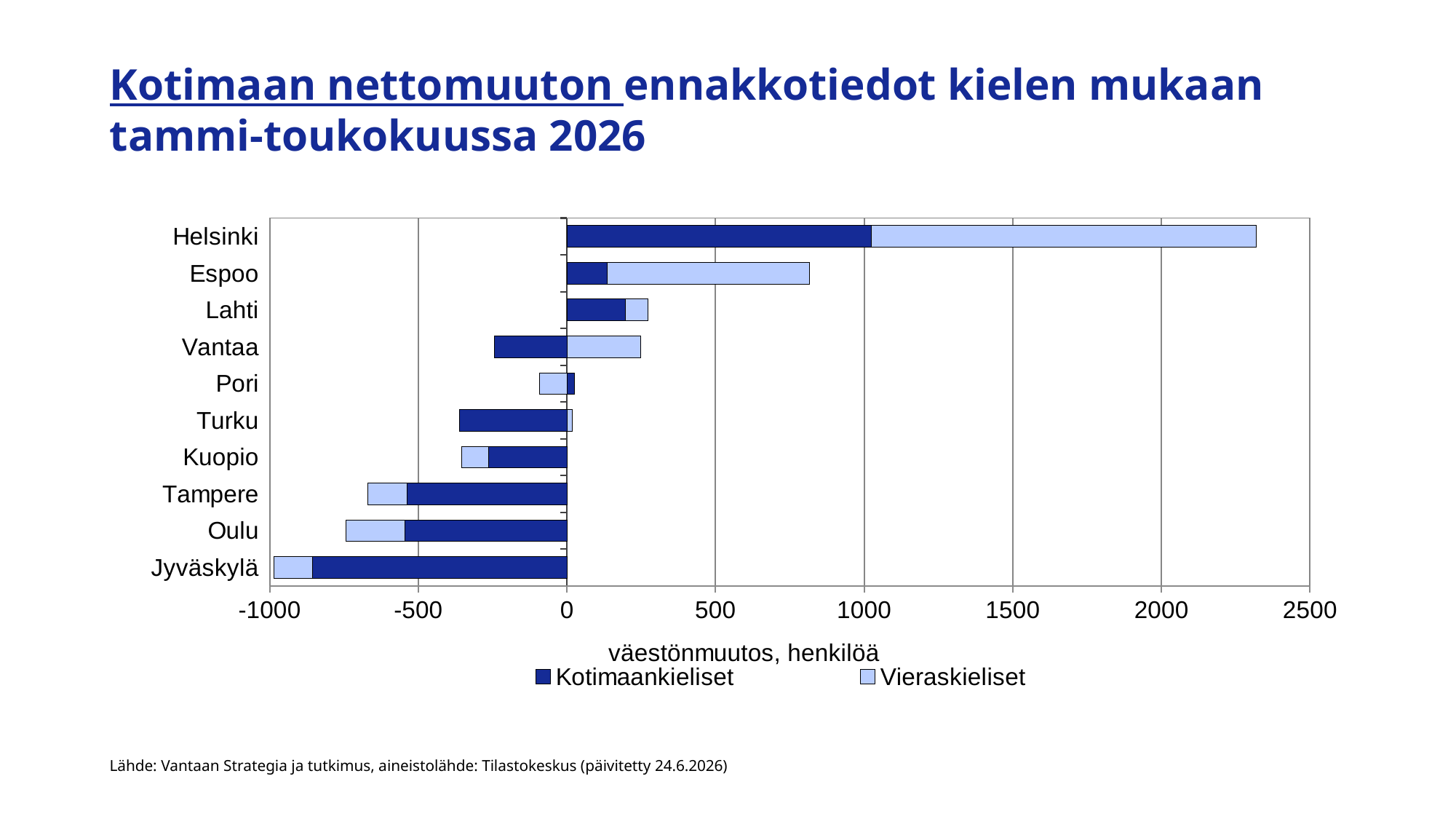
What kind of chart is shown on the slide? Bar chart Is the Kotimaankieliset value for Espoo greater or less than 500? less Is the Kotimaankieliset value for Jyväskylä greater or less than -500? less How many cities are listed on the vertical axis of the chart? 10 Which city has the highest Kotimaankieliset value? Helsinki Is the Vieraskieliset value for Helsinki greater or less than 1000? greater Which is larger, the Vieraskieliset value for Vantaa or for Lahti? Vantaa Which city has the lowest Kotimaankieliset value? Jyväskylä What is the label of the horizontal axis of the chart? väestönmuutos, henkilöä Which is larger, the Vieraskieliset value for Helsinki or for Espoo? Helsinki How many series does the chart legend list? 2